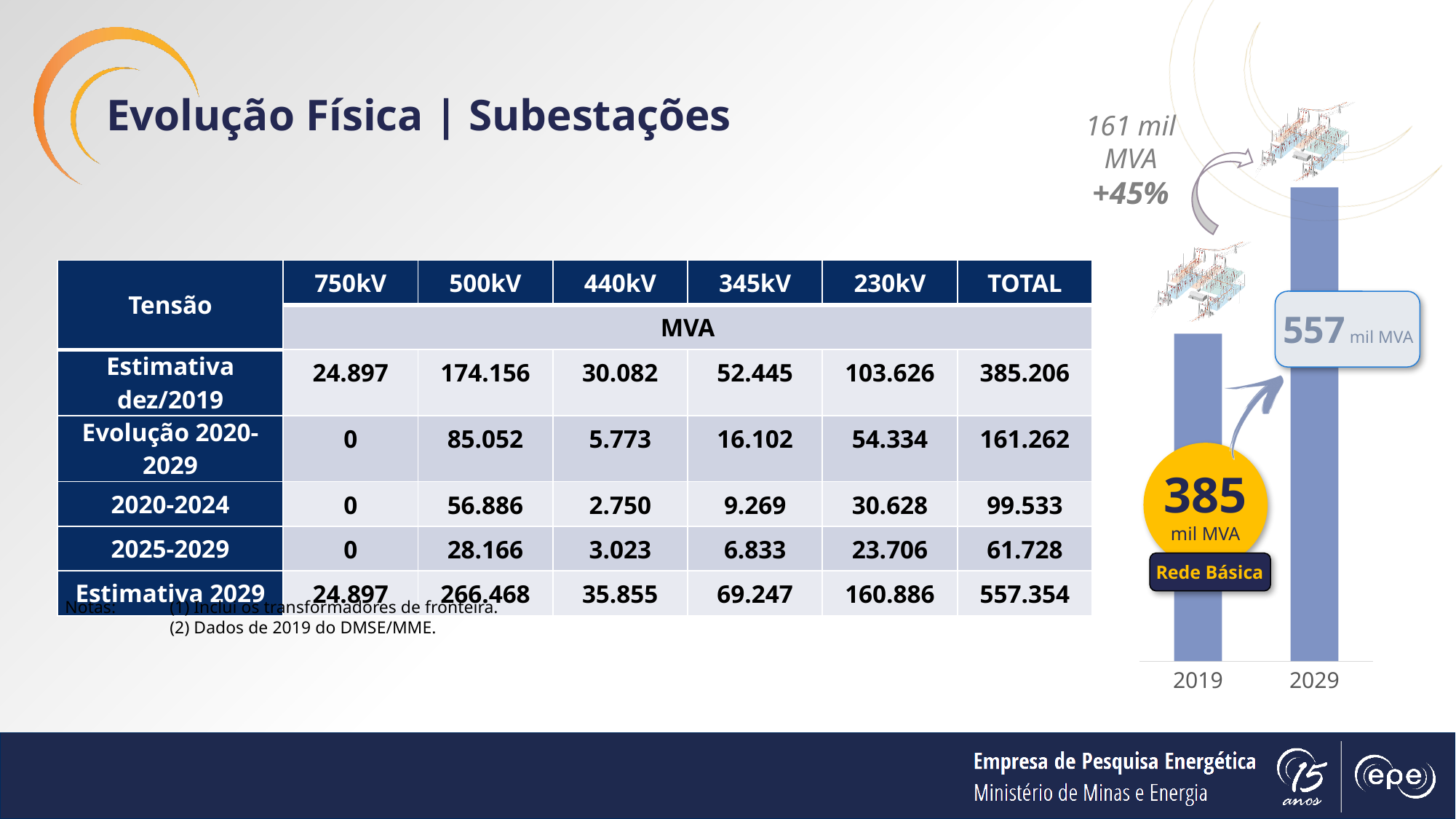
In the bar chart on the right, is the value for 2029 larger or smaller than the value for 2019? larger In the bar chart on the right, what are the two categories on the x axis? 2019 and 2029 In the bar chart on the right, what value is labelled for 2029? 557 mil MVA In the bar chart on the right, do the values rise or fall from 2019 to 2029? rise In the bar chart on the right, what percentage increase is labelled between 2019 and 2029? +45% In the bar chart on the right, which year has the shorter bar? 2019 In the bar chart on the right, what value is labelled for 2019? 385 mil MVA In the bar chart on the right, what increase in MVA is labelled next to the arrow between the two bars? 161 mil MVA How many bars does the chart on the right of the slide have? 2 In the bar chart on the right, which year has the taller bar? 2029 What kind of chart is shown on the right side of the slide? bar chart